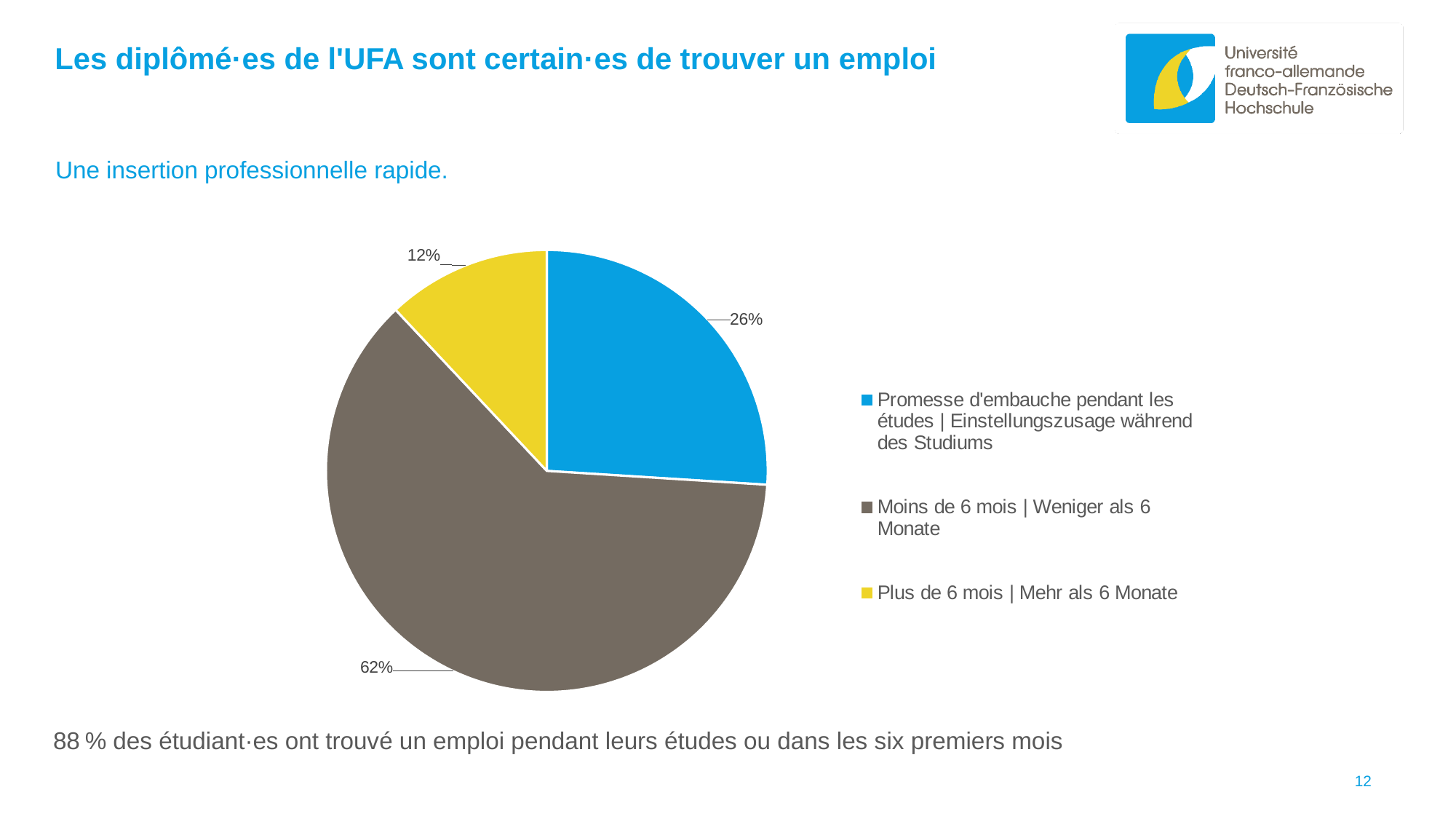
Which category has the smallest slice of the pie? Plus de 6 mois | Mehr als 6 Monate What kind of chart is shown on the slide? pie chart What share of the pie is labelled 'Promesse d'embauche pendant les études | Einstellungszusage während des Studiums'? 26% Which is larger: the 'Promesse d'embauche pendant les études' slice or the 'Plus de 6 mois' slice? Promesse d'embauche pendant les études Which category has the largest slice of the pie? Moins de 6 mois | Weniger als 6 Monate How many slices does the pie chart have? 3 How many entries does the legend list? 3 What share of the pie is labelled 'Plus de 6 mois | Mehr als 6 Monate'? 12% What colour is the slice for 'Plus de 6 mois | Mehr als 6 Monate'? yellow What share of the pie is labelled 'Moins de 6 mois | Weniger als 6 Monate'? 62% What is the difference in percentage points between the 'Moins de 6 mois' slice and the 'Promesse d'embauche pendant les études' slice? 36 What is the combined share of the 'Promesse d'embauche pendant les études' and 'Moins de 6 mois' slices? 88%